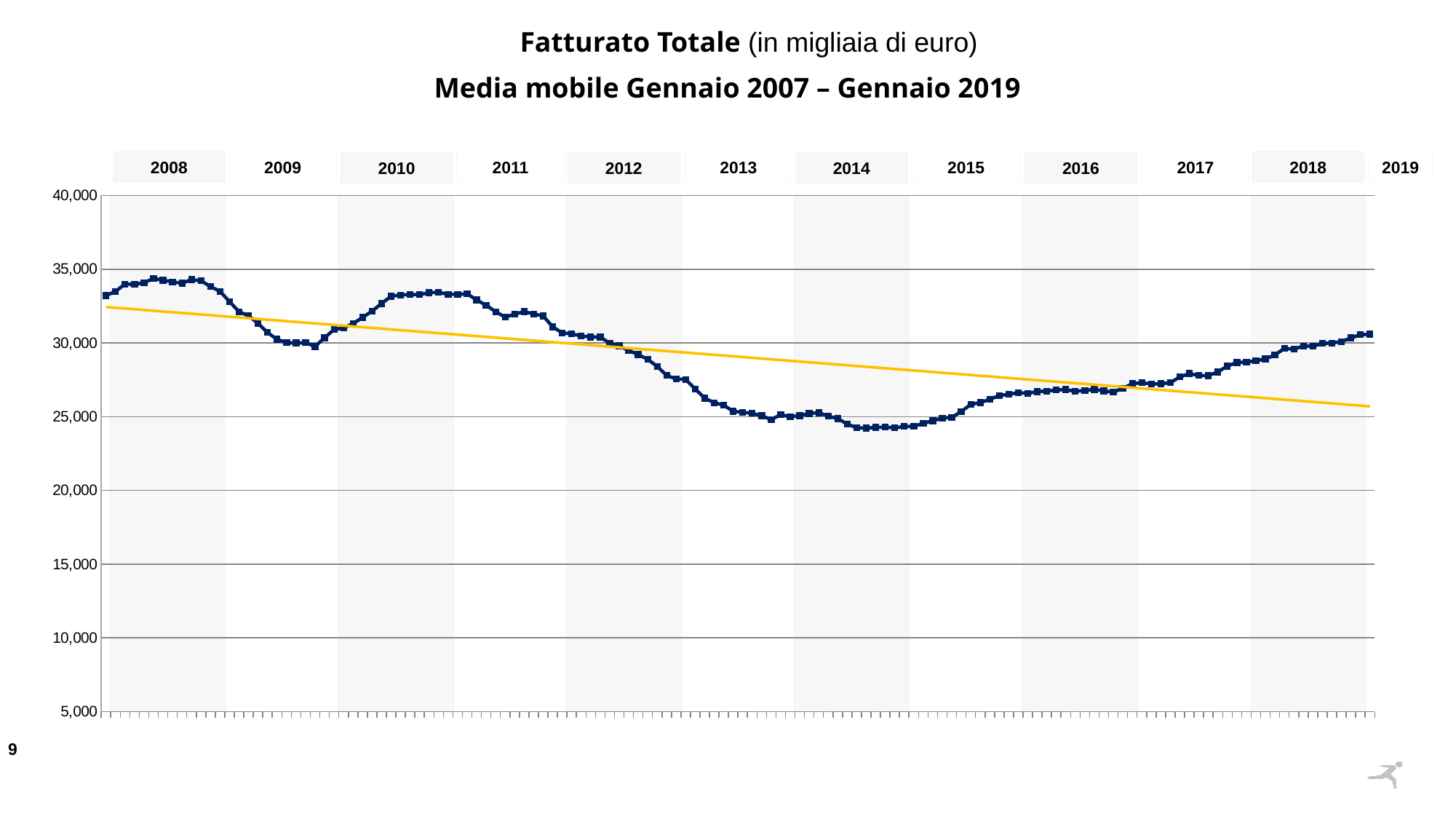
What kind of chart is shown on the slide? line chart What period does the moving average cover according to the subtitle? Gennaio 2007 – Gennaio 2019 In which year does the moving average reach its highest values? 2008 Is the value of the moving average in 2008 greater or less than 30,000? greater Which is larger, the moving average in 2008 or in 2016? 2008 Is the value of the moving average in 2016 greater or less than 30,000? less What is the title of the chart? Fatturato Totale (in migliaia di euro) Is the value of the moving average in 2010 greater or less than 30,000? greater In which year does the moving average reach its lowest values? 2014 Does the yellow trend line rise or fall from left to right? fall